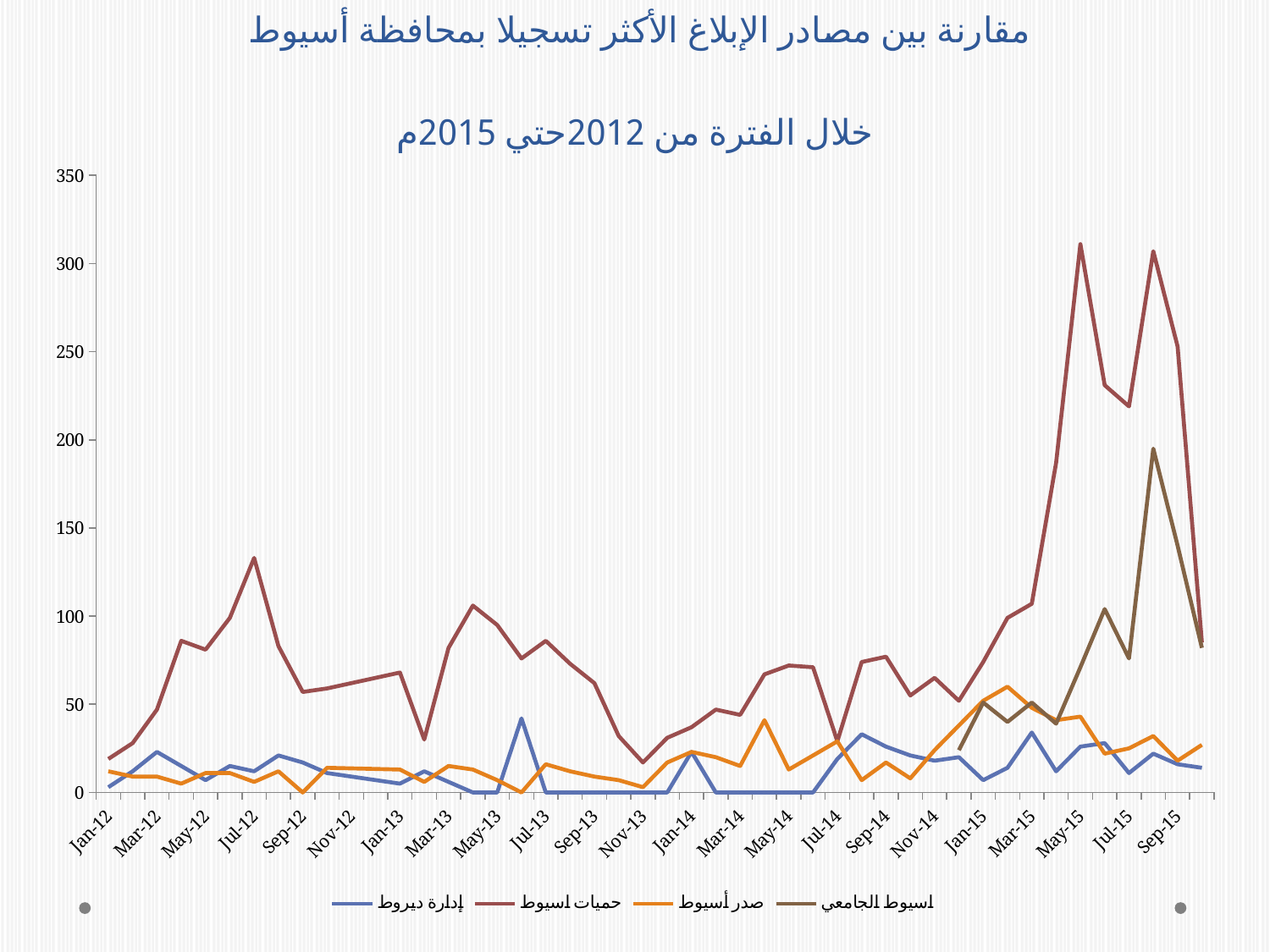
Which series reaches the highest value on the chart? حميات اسيوط In Jul-12, which series has the larger value, حميات اسيوط or إدارة ديروط? حميات اسيوط Is the highest value reached by إدارة ديروط greater or less than 50? less What is the maximum value shown on the vertical axis? 350 What type of chart is shown on the slide? line chart Does the value for حميات اسيوط rise or fall between Mar-15 and May-15? rise Is the value for حميات اسيوط in Jul-12 greater or less than 100? greater Is the value for حميات اسيوط in May-15 greater or less than 250? greater Which series is drawn in blue? إدارة ديروط How many series does the legend list? 4